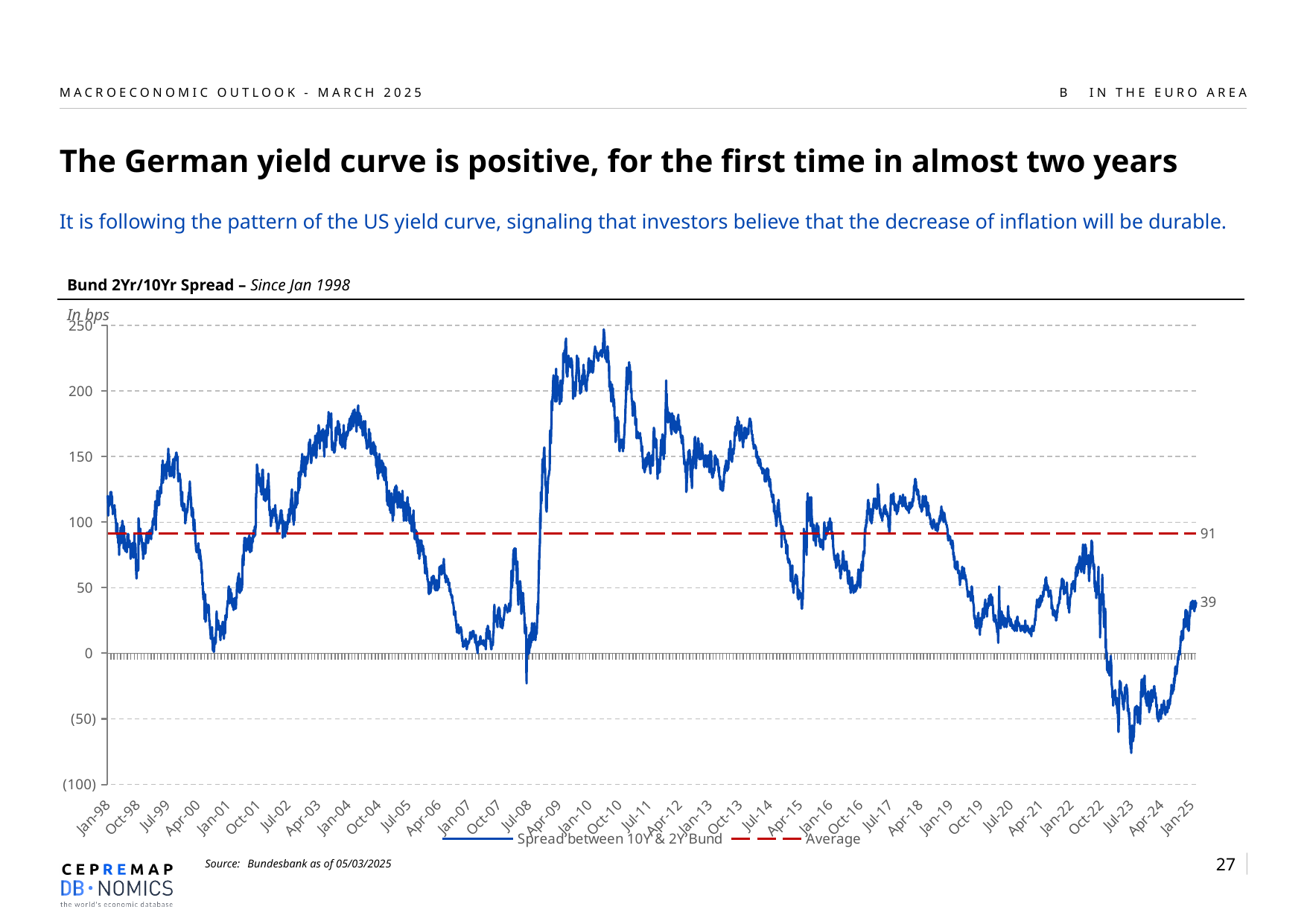
What is the value of the Average line shown on the chart? 91 Is the spread around Jul-23 greater or less than 0? less Does the spread rise or fall between Jul-23 and Jan-25? rise What unit is the y axis expressed in, according to the label above the axis? In bps Which is larger, the Average line or the latest spread value at Jan-25? Average What is the difference between the Average (91) and the latest spread value (39)? 52 What kind of chart is shown on the slide? line chart In which year does the spread reach its highest point on the chart? 2010 How many series does the legend list? 2 What is the latest value of the spread between 10Y & 2Y Bund, labelled at the right end of the line? 39 Is the spread around Jan-04 greater or less than 150? greater Is the spread around Oct-10 greater or less than 200? greater